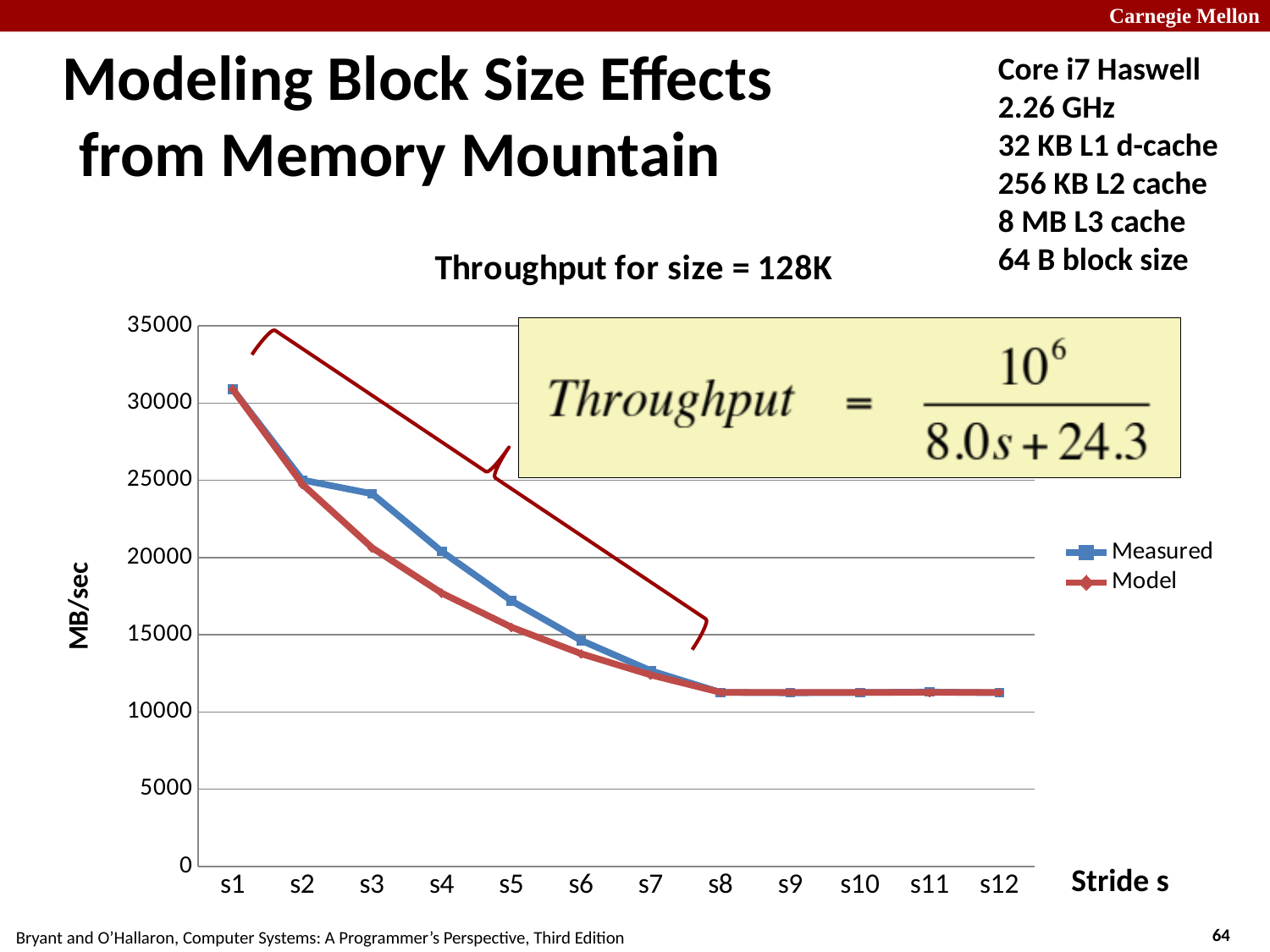
At stride s3, which series has the larger value, Measured or Model? Measured Is the Model value at s4 greater or less than 15000? greater How many stride values are plotted along the x axis? 12 How many series does the legend list? 2 Is the Measured value at s8 greater or less than 15000? less What is the label on the y axis? MB/sec What is the title of the chart? Throughput for size = 128K Is the Measured value at s1 greater or less than 25000? greater At which stride is the Measured throughput highest? s1 Do the Measured values rise or fall from s1 to s8? fall At stride s4, which series has the larger value, Measured or Model? Measured What kind of chart is shown on the slide? line chart